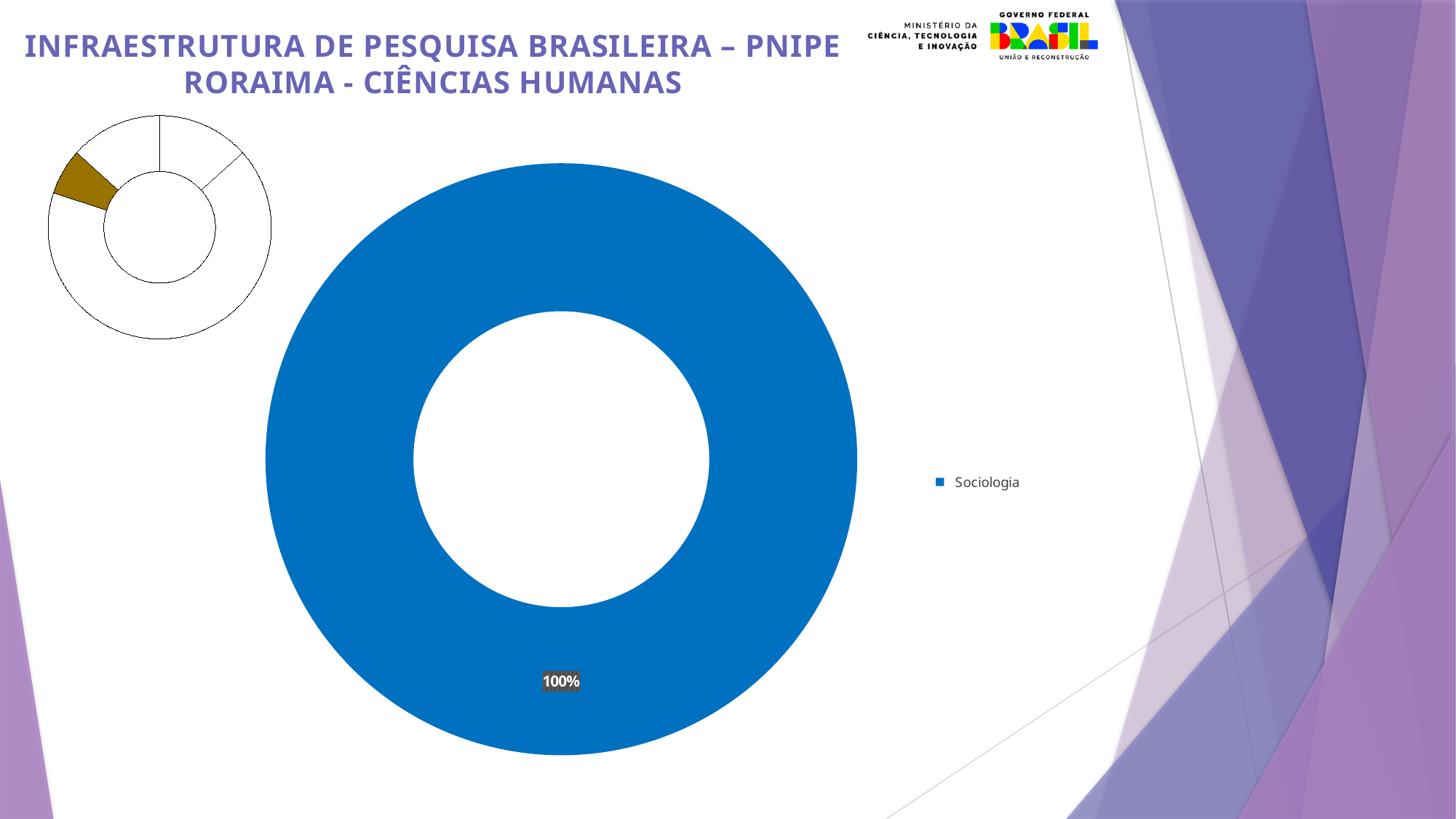
How many categories are plotted in the large doughnut chart? 1 What colour is the Sociologia slice in the large doughnut chart? Blue How many entries does the legend of the large doughnut chart list? 1 What share of the doughnut chart does the Sociologia slice take up? 100% What percentage is shown for Sociologia in the doughnut chart? 100% Which category is the only one listed in the legend of the large chart? Sociologia What kind of chart is the large chart in the centre of the slide? Doughnut (pie) chart